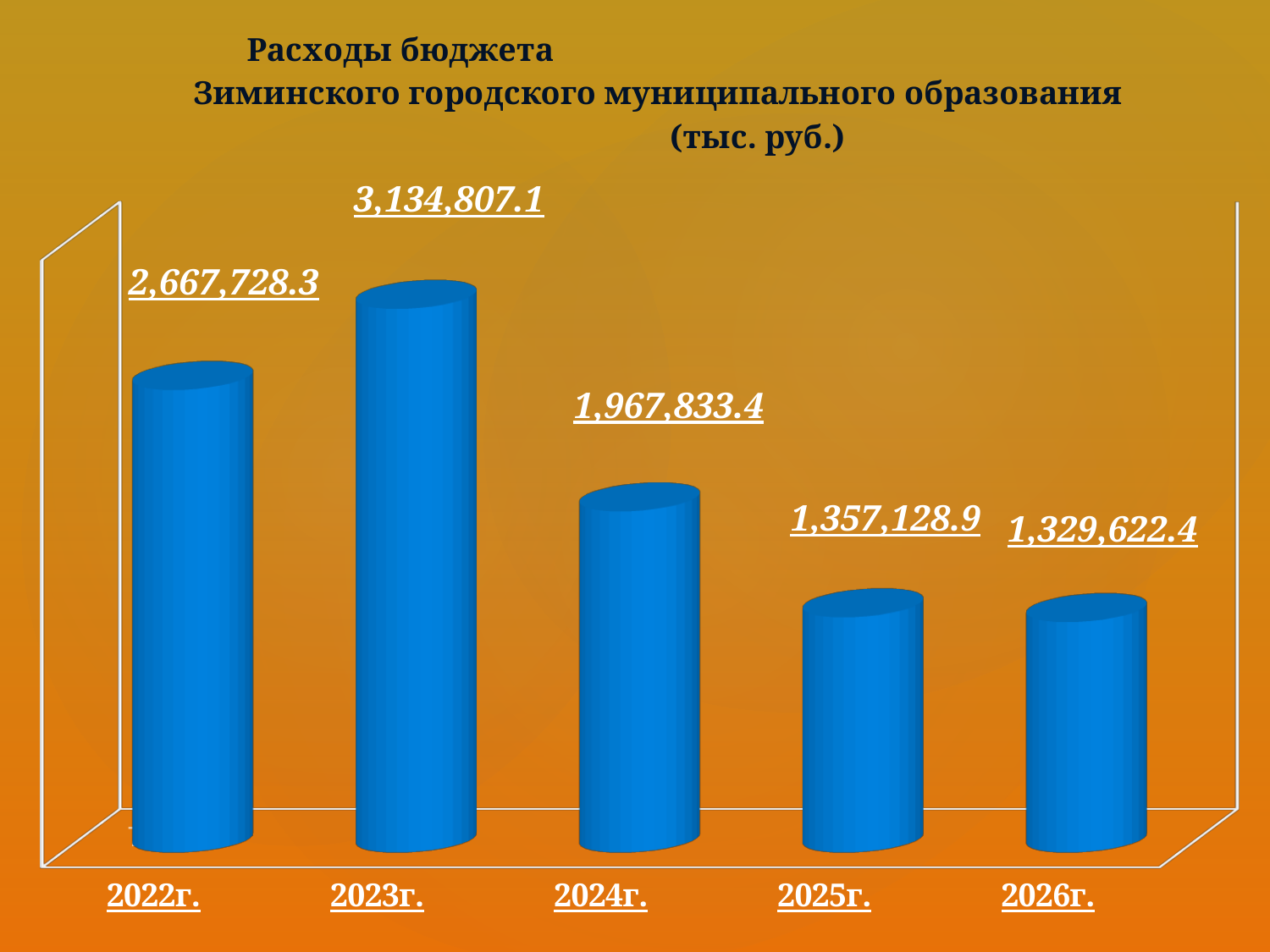
Do the values rise or fall from 2023г. to 2026г.? Fall In what units are the values on the chart expressed, according to the title? тыс. руб. Which year has the lowest budget expenditure? 2026г. Which is larger, the value for 2022г. or the value for 2024г.? 2022г. What kind of chart is this? Bar chart What is the budget expenditure value shown for 2023г.? 3,134,807.1 Which year has the highest budget expenditure? 2023г. How many years are shown on the chart? 5 What is the value shown for 2026г.? 1,329,622.4 What is the difference between the values for 2025г. and 2026г.? 27,506.5 What is the value shown for 2024г.? 1,967,833.4 What is the difference between the values for 2023г. and 2022г.? 467,078.8